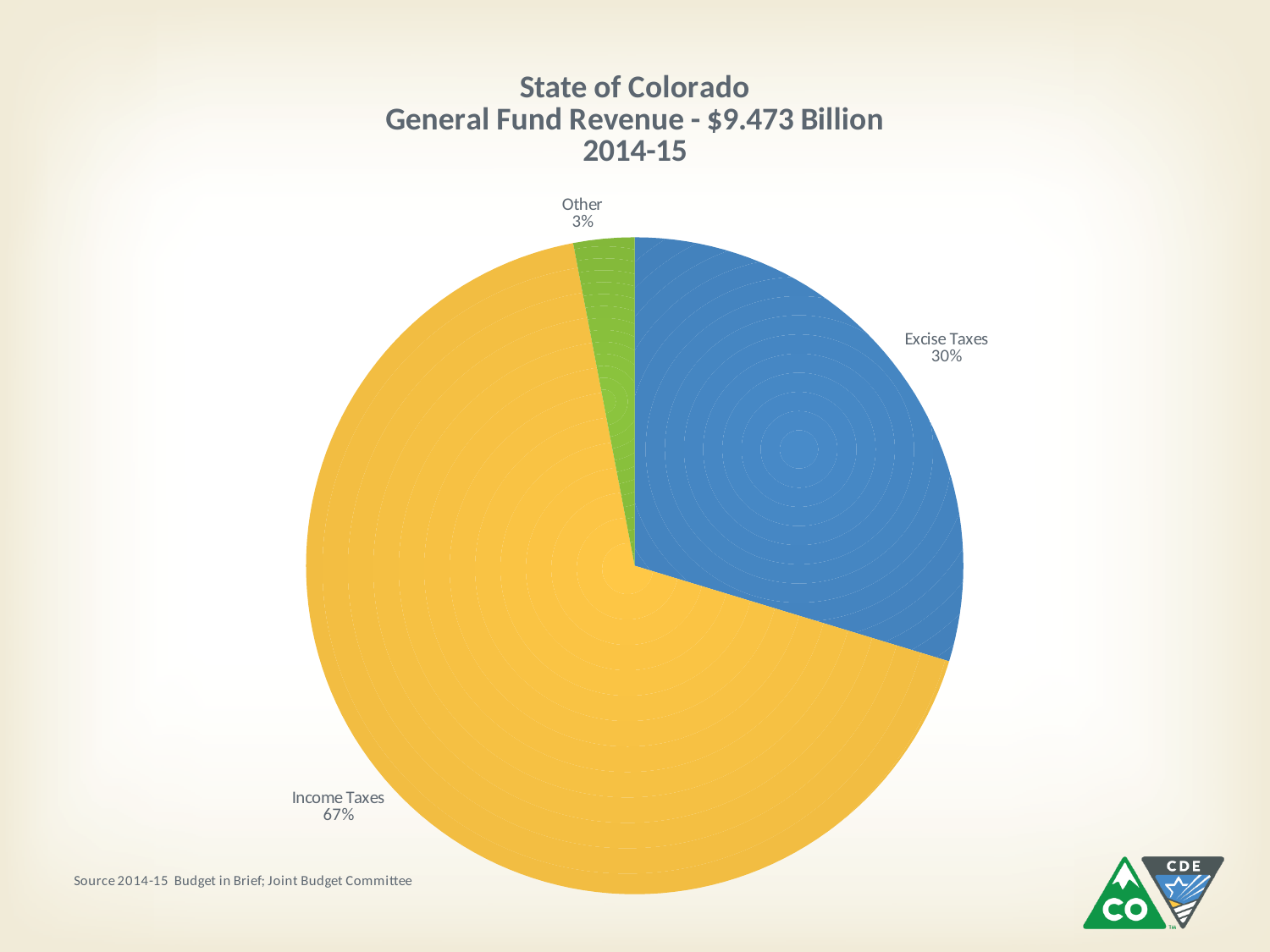
What kind of chart is shown on the slide? pie chart What share of General Fund Revenue comes from Excise Taxes? 30% Which fiscal year does the chart cover? 2014-15 What share of General Fund Revenue is labelled Other? 3% Which is larger, the Excise Taxes share or the Other share? Excise Taxes What total General Fund Revenue amount is stated in the chart title? $9.473 Billion Which category has the largest share of the pie? Income Taxes What share of General Fund Revenue comes from Income Taxes? 67% How many slices does the pie chart have? 3 What is the difference in percentage points between the Income Taxes share and the Excise Taxes share? 37 Which category has the smallest share of the pie? Other